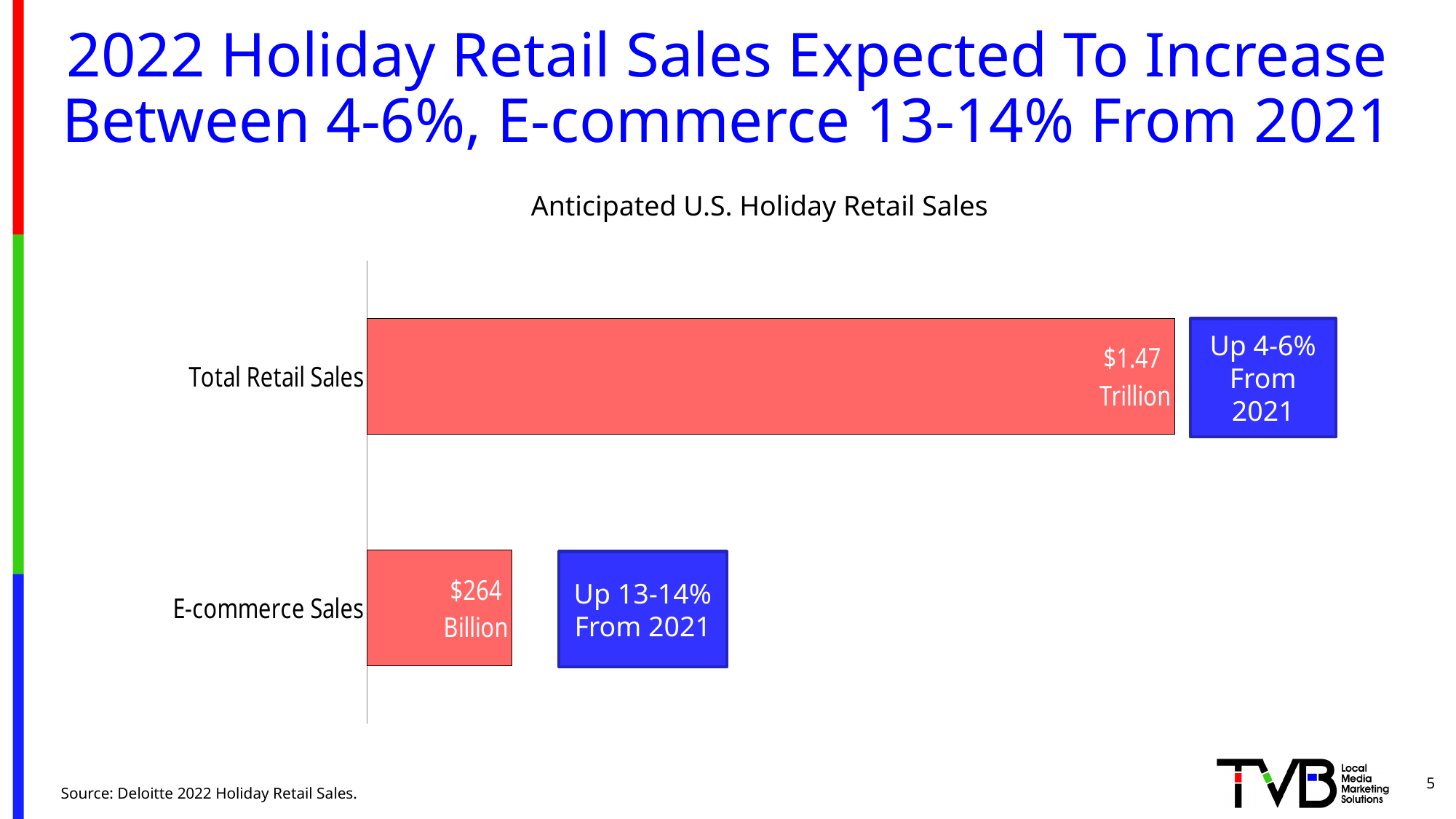
How many categories are plotted in the chart? 2 What is the title of the chart? Anticipated U.S. Holiday Retail Sales What kind of chart is shown on the slide? Bar chart What is the value shown for E-commerce Sales? $264 Billion Which is larger, Total Retail Sales or E-commerce Sales? Total Retail Sales What expected change from 2021 is annotated next to the E-commerce Sales bar? Up 13-14% From 2021 What expected change from 2021 is annotated next to the Total Retail Sales bar? Up 4-6% From 2021 What is the value shown for Total Retail Sales? $1.47 Trillion Which category has the highest value? Total Retail Sales Which category has the lowest value? E-commerce Sales